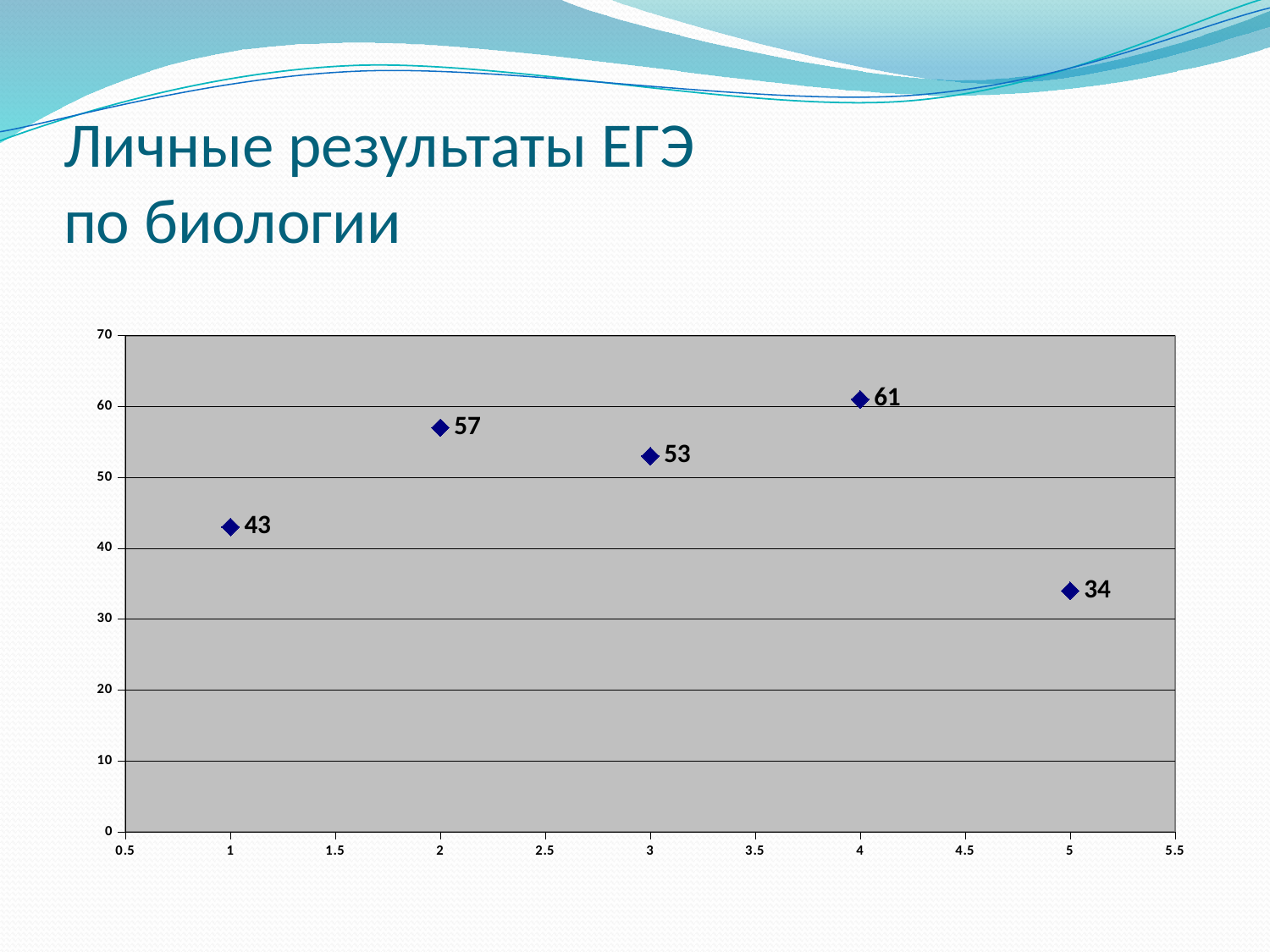
What is the difference between the values at x = 4 and x = 5? 27 How many data points are plotted on the chart? 5 What is the value of the point at x = 5? 34 At which x value is the lowest point plotted? 5 What is the value of the point at x = 4? 61 What is the value of the point at x = 1? 43 At which x value is the highest point plotted? 4 What is the difference between the values at x = 2 and x = 1? 14 Which is larger, the value at x = 2 or the value at x = 3? x = 2 What is the title of the slide containing the chart? Личные результаты ЕГЭ по биологии What is the value of the point at x = 3? 53 What kind of chart is shown on the slide? scatter chart